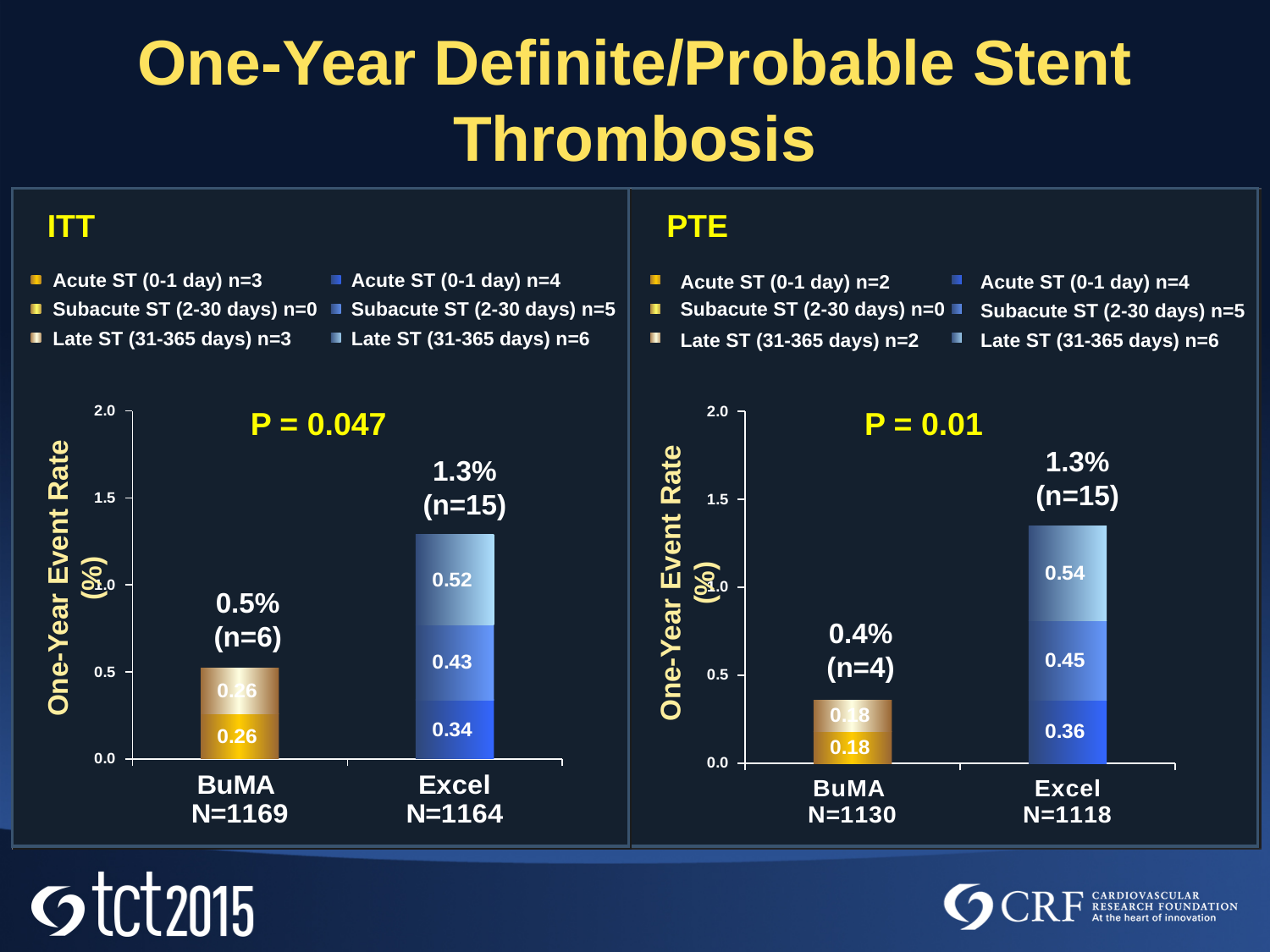
How many groups (bars) are plotted in the PTE chart? 2 In the PTE chart, what is the one-year event rate printed above the BuMA bar? 0.4% In the ITT chart, which group has the higher one-year event rate, BuMA or Excel? Excel In the ITT chart, what is the one-year event rate printed above the Excel bar? 1.3% What P value is printed on the PTE chart? P = 0.01 In the PTE chart, what value is printed on the bottom segment of the Excel bar? 0.36 In the ITT chart, what is the one-year event rate printed above the BuMA bar? 0.5% What type of chart is used in the ITT panel? Stacked bar chart In the PTE chart, what is the difference between the Excel and BuMA one-year event rates? 0.9% In the PTE chart, what is the number of events (n) shown for the Excel group? n=15 In the ITT chart, what value is printed on the top segment of the Excel bar? 0.52 In the ITT chart, is the total height of the Excel bar greater or less than 1.0? greater